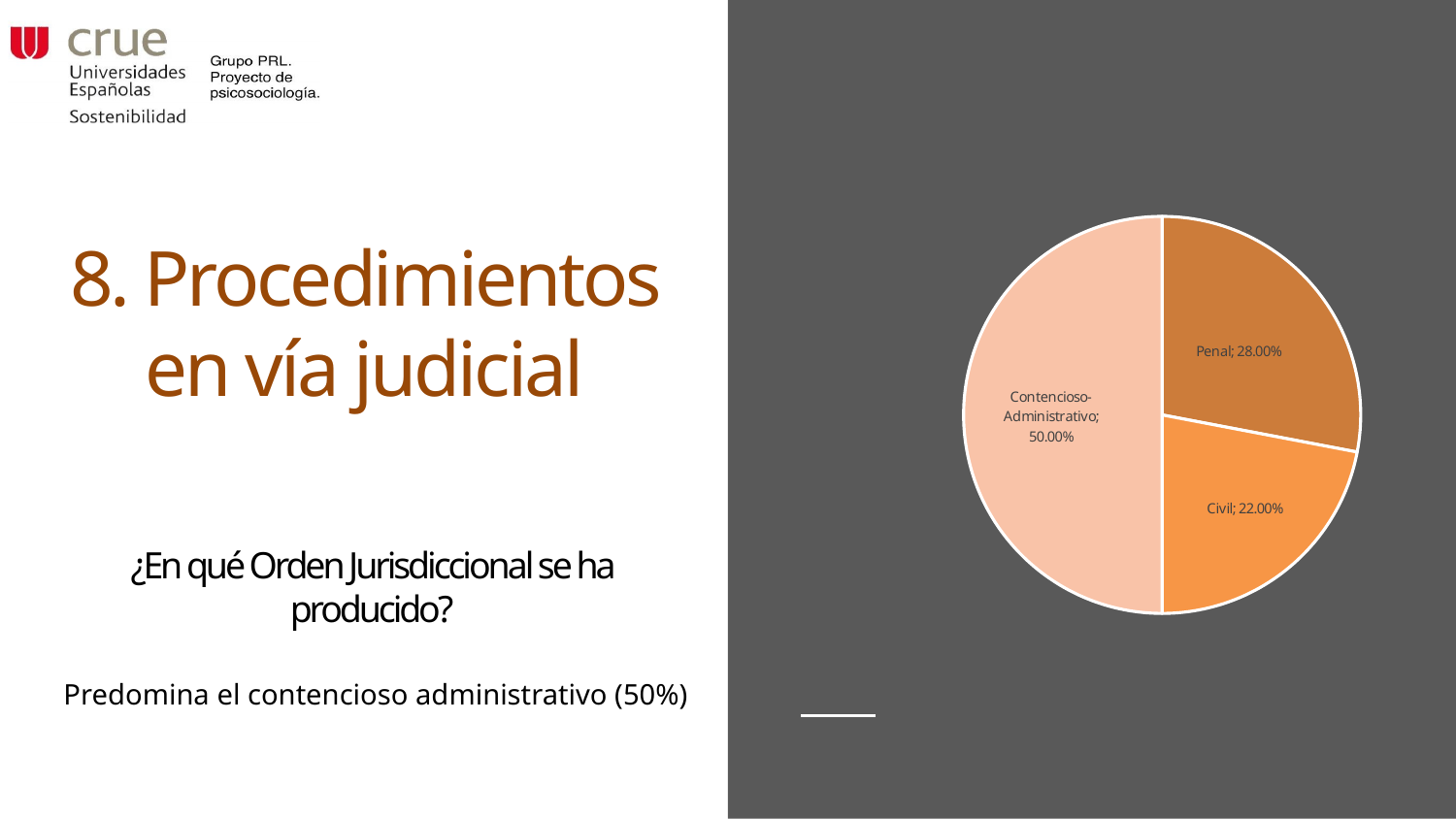
What is the difference between the Penal and Civil values? 6.00% How many slices does the pie chart have? 3 What is the value for Contencioso-Administrativo in the pie chart? 50.00% What kind of chart is shown on the slide? pie chart Which is larger, Penal or Civil? Penal What is the difference between the Contencioso-Administrativo and Penal values? 22.00% What question does the slide pose above the summary text about the chart? ¿En qué Orden Jurisdiccional se ha producido? Which category has the largest slice in the pie chart? Contencioso-Administrativo Which category has the smallest slice in the pie chart? Civil What is the value for Penal in the pie chart? 28.00% What is the value for Civil in the pie chart? 22.00% What share of the pie does Contencioso-Administrativo represent? 50.00%